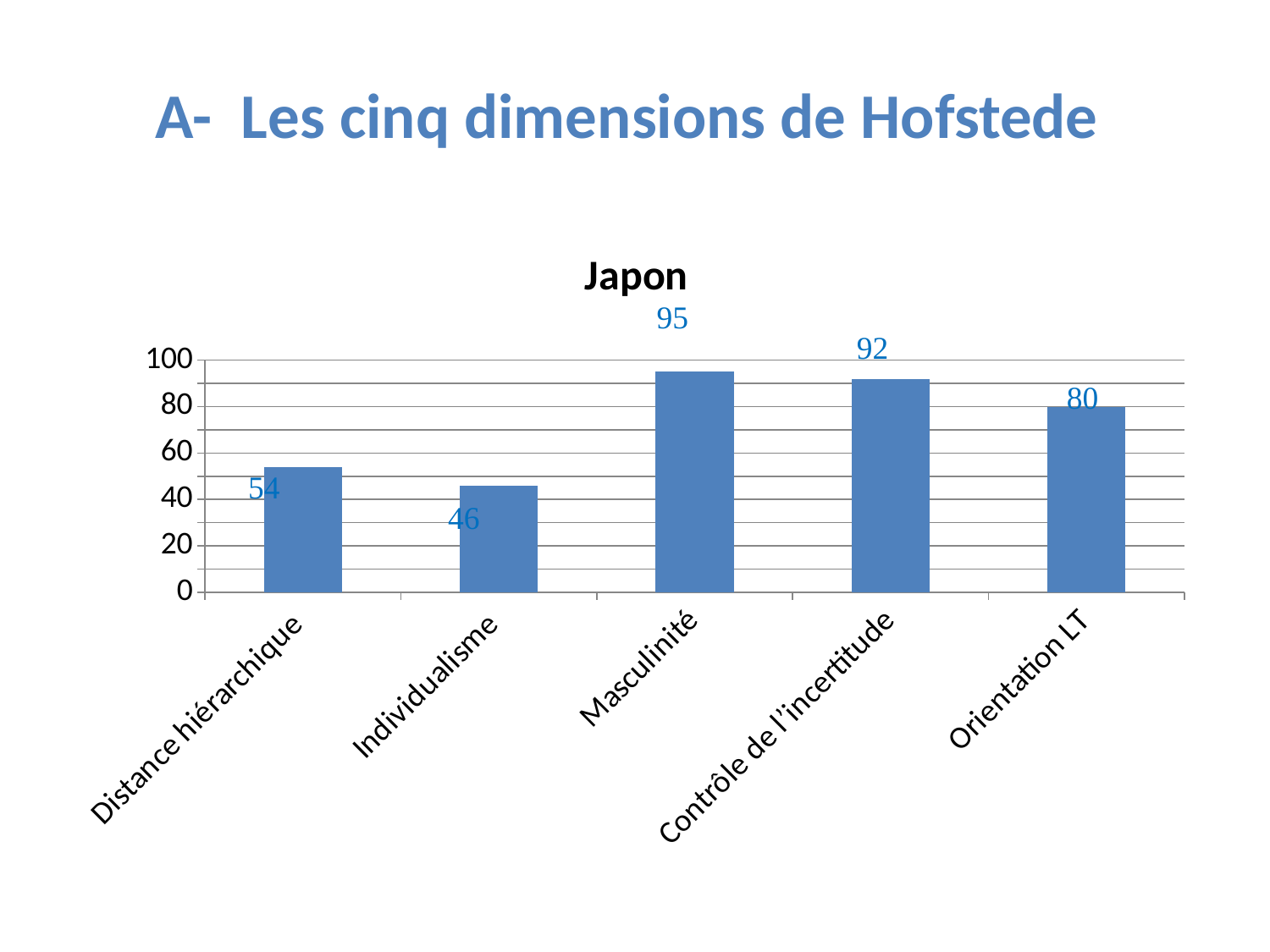
What is the value for Individualisme? 46 Which dimension has the highest value? Masculinité What is the title of the chart? Japon Which is larger, the value for Distance hiérarchique or the value for Individualisme? Distance hiérarchique What is the difference between the values for Masculinité and Individualisme? 49 What is the value for Orientation LT? 80 What is the value for Masculinité? 95 Which dimension has the lowest value? Individualisme How many dimensions are shown on the chart? 5 What is the value for Distance hiérarchique? 54 What kind of chart is shown? Bar chart What is the difference between the values for Contrôle de l'incertitude and Orientation LT? 12